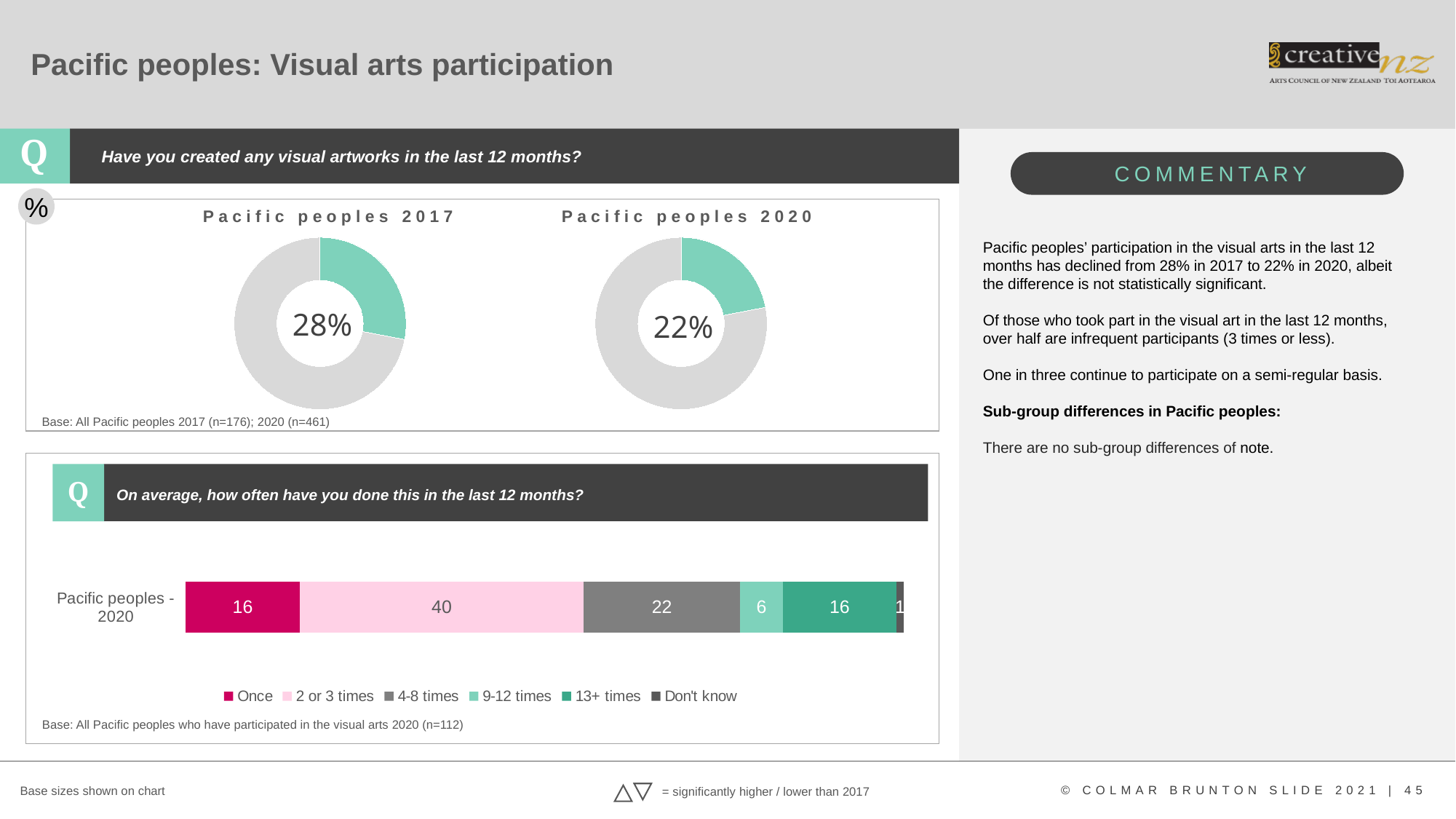
In the stacked bar chart for 'Pacific peoples - 2020', what is the value for '2 or 3 times'? 40 In the stacked bar chart for 'Pacific peoples - 2020', what is the value for '4-8 times'? 22 In the stacked bar chart for 'Pacific peoples - 2020', which frequency category has the largest value? 2 or 3 times What type of chart is used to show the 'Pacific peoples 2017' and 'Pacific peoples 2020' participation figures? Donut chart In the 'Pacific peoples 2020' donut chart, what percentage is shown in the centre? 22% What is the difference between the percentage in the 'Pacific peoples 2017' donut chart and the 'Pacific peoples 2020' donut chart? 6 percentage points Comparing the two donut charts, which year shows the higher participation percentage, 2017 or 2020? 2017 In the stacked bar chart for 'Pacific peoples - 2020', what is the difference between the values for '2 or 3 times' and '4-8 times'? 18 In the stacked bar chart for 'Pacific peoples - 2020', what is the value for '9-12 times'? 6 In the 'Pacific peoples 2017' donut chart, what percentage is shown in the centre? 28% How many series does the legend of the stacked bar chart list? 6 In the stacked bar chart for 'Pacific peoples - 2020', which frequency category has the smallest value? Don't know